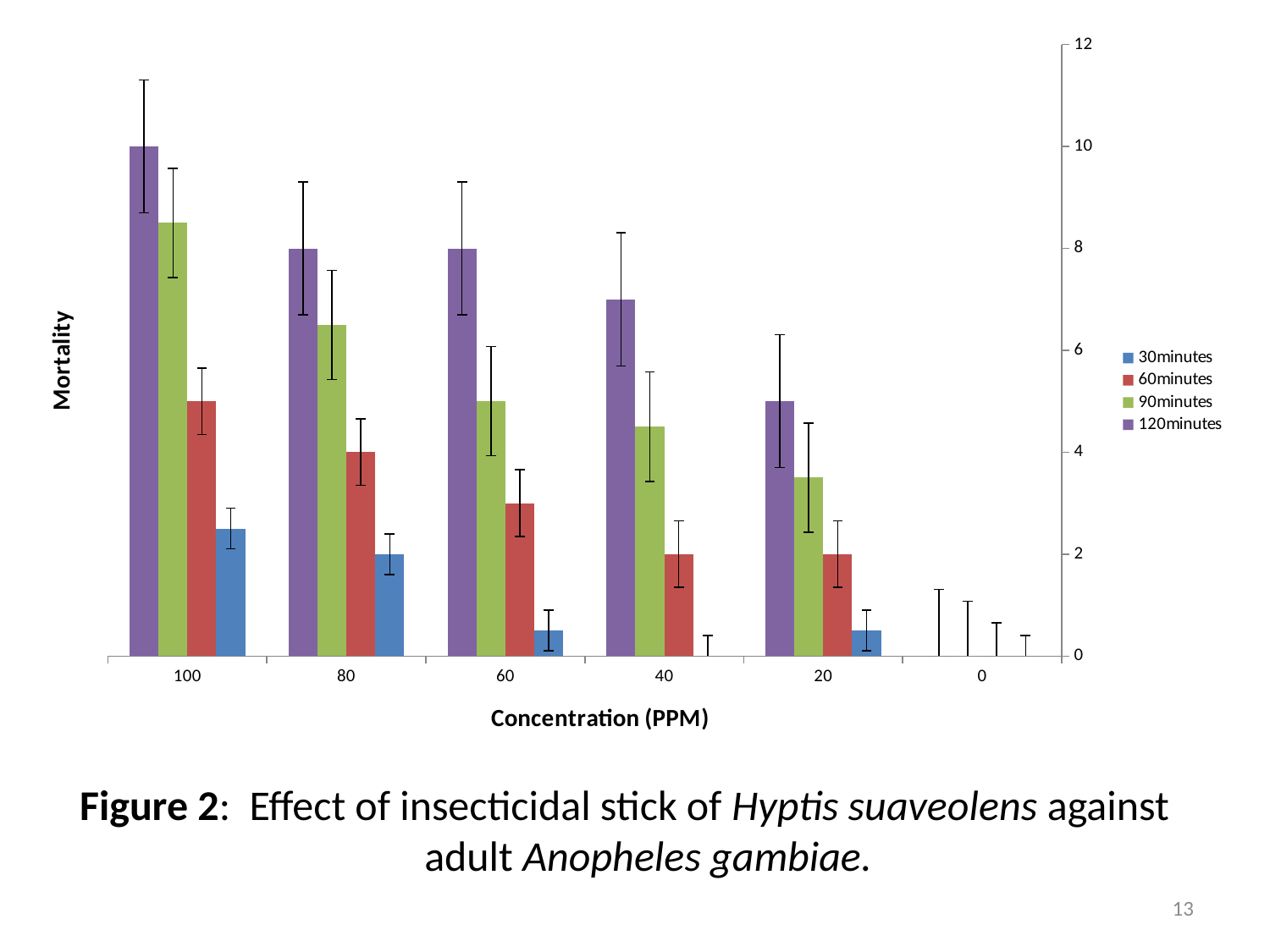
What is the mortality value for 120minutes at a concentration of 100 PPM? 10 What is the mortality value for 120minutes at a concentration of 80 PPM? 8 How many series does the legend list? 4 What is the mortality value for 60minutes at a concentration of 40 PPM? 2 How many concentration categories are shown on the x axis? 6 What type of chart is shown on the slide? bar chart Is the value for 90minutes at 100 PPM greater or less than 8? greater Is the value for 120minutes at 40 PPM greater or less than 8? less Which series has the highest mortality at 100 PPM? 120minutes Is the value for 30minutes at 60 PPM greater or less than 2? less What is the mortality value for 60minutes at a concentration of 80 PPM? 4 Does the mortality for 120minutes rise or fall as the concentration goes from 100 to 0 along the x axis? fall